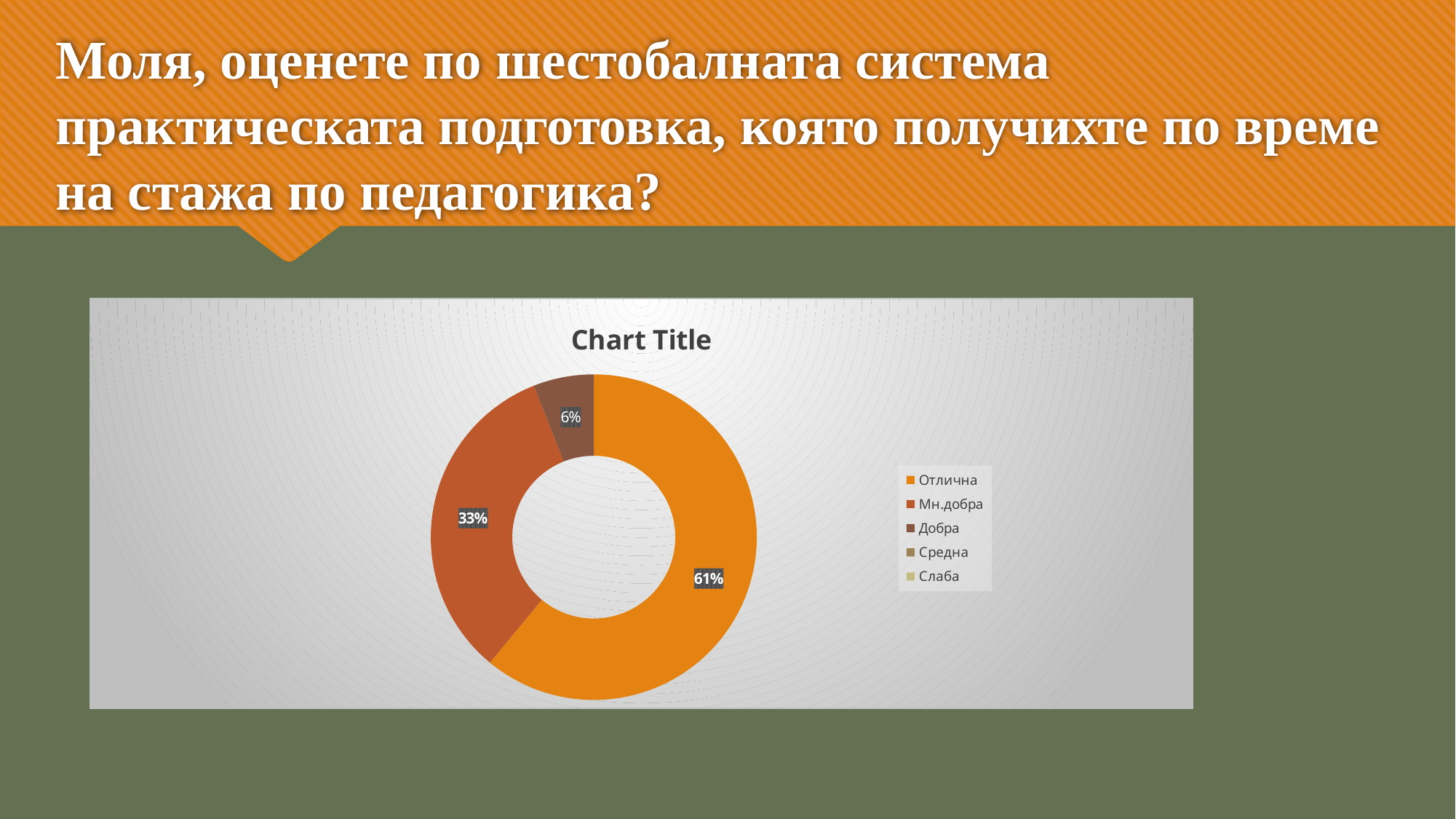
What kind of chart is shown on the slide? Doughnut chart Which of the visible slices has the smallest share in the chart? Добра Which is larger, the share for Мн.добра or the share for Добра? Мн.добра What is the difference in percentage points between the Отлична and Мн.добра shares? 28 How many entries does the legend list? 5 What is the title shown above the chart? Chart Title Which category has the largest share in the chart? Отлична What share of the doughnut chart does Мн.добра take? 33% What share of the doughnut chart does Добра take? 6% What share of the doughnut chart does Отлична take? 61% What colour is the Отлична slice? Orange What is the combined share of Отлична and Мн.добра? 94%